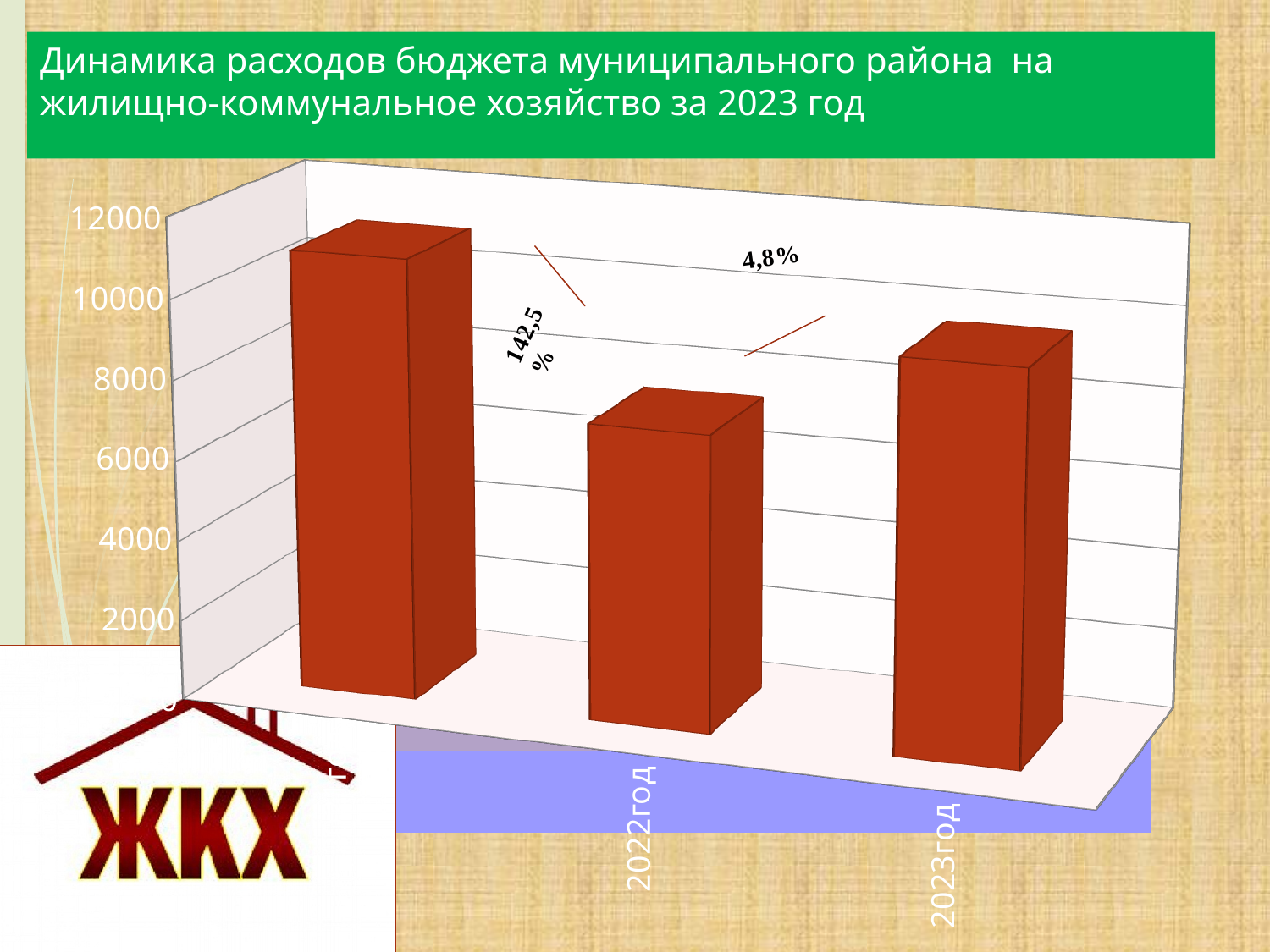
Is the value for 2023год greater or less than 10000? less What kind of chart is shown on the slide? bar chart Which bar is taller, 2022год or 2023год? 2023год Which labelled year has the lowest bar on the chart? 2022год Is the value for 2022год greater or less than 10000? less What percentage annotation is written above the 2023год bar? 4,8% Is the value for 2022год greater or less than 4000? greater How many bars does the chart contain? 3 Does the value rise or fall from 2022год to 2023год? rise What is the highest tick value shown on the vertical axis? 12000